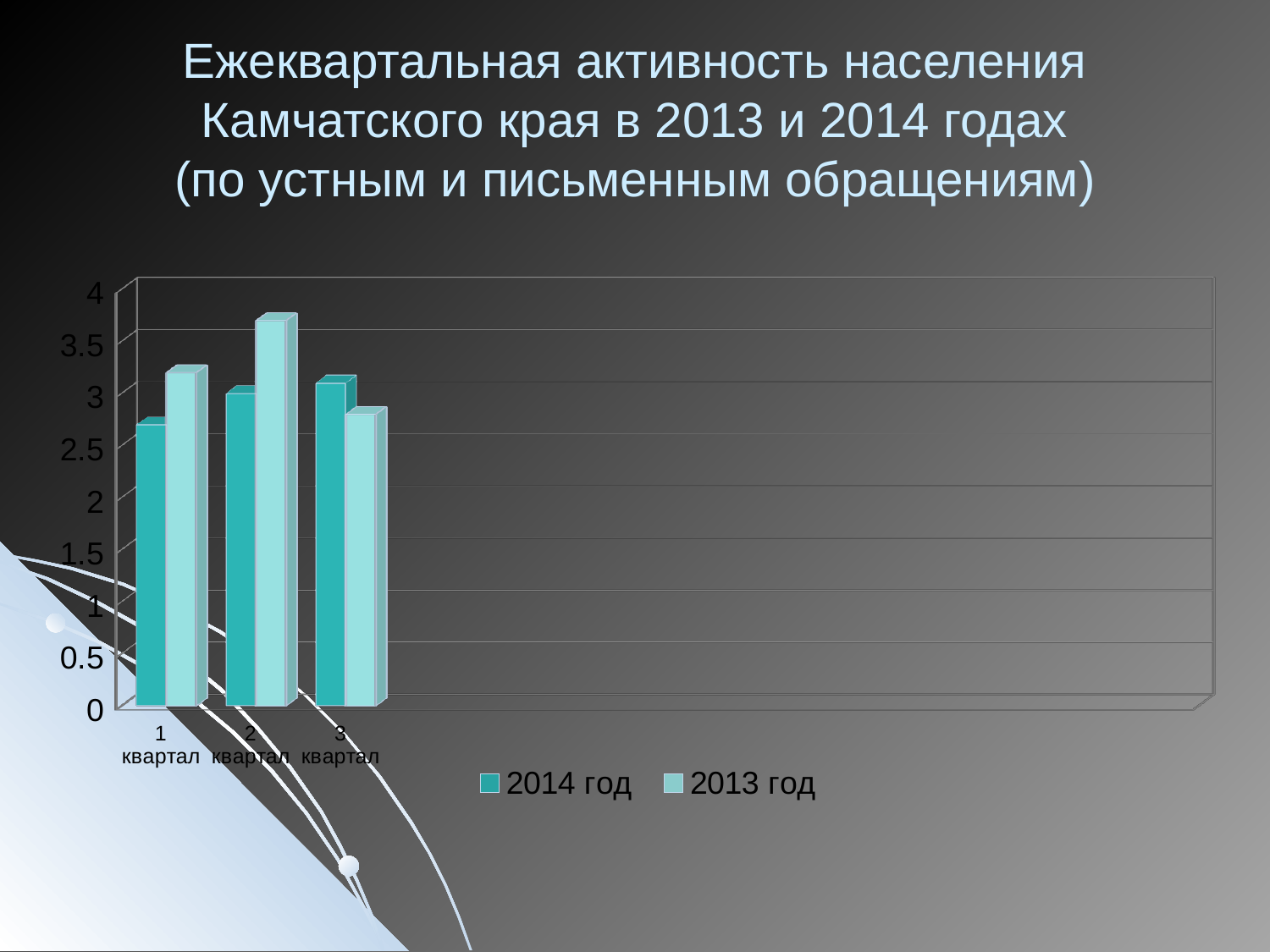
Is the value for 2013 год in 3 квартал greater or less than 3? less How many series does the legend list? 2 Is the value for 2013 год in 2 квартал greater or less than 3.5? greater Is the value for 2013 год in 1 квартал greater or less than 3? greater What kind of chart is shown on the slide? Bar chart In which quarter is the value for 2013 год the highest? 2 квартал How many quarters (categories) are shown on the x axis? 3 In which quarter is the value for 2014 год the lowest? 1 квартал Which series does the legend list first? 2014 год In 3 квартал, which series has the larger value, 2014 год or 2013 год? 2014 год In 1 квартал, which series has the larger value, 2014 год or 2013 год? 2013 год